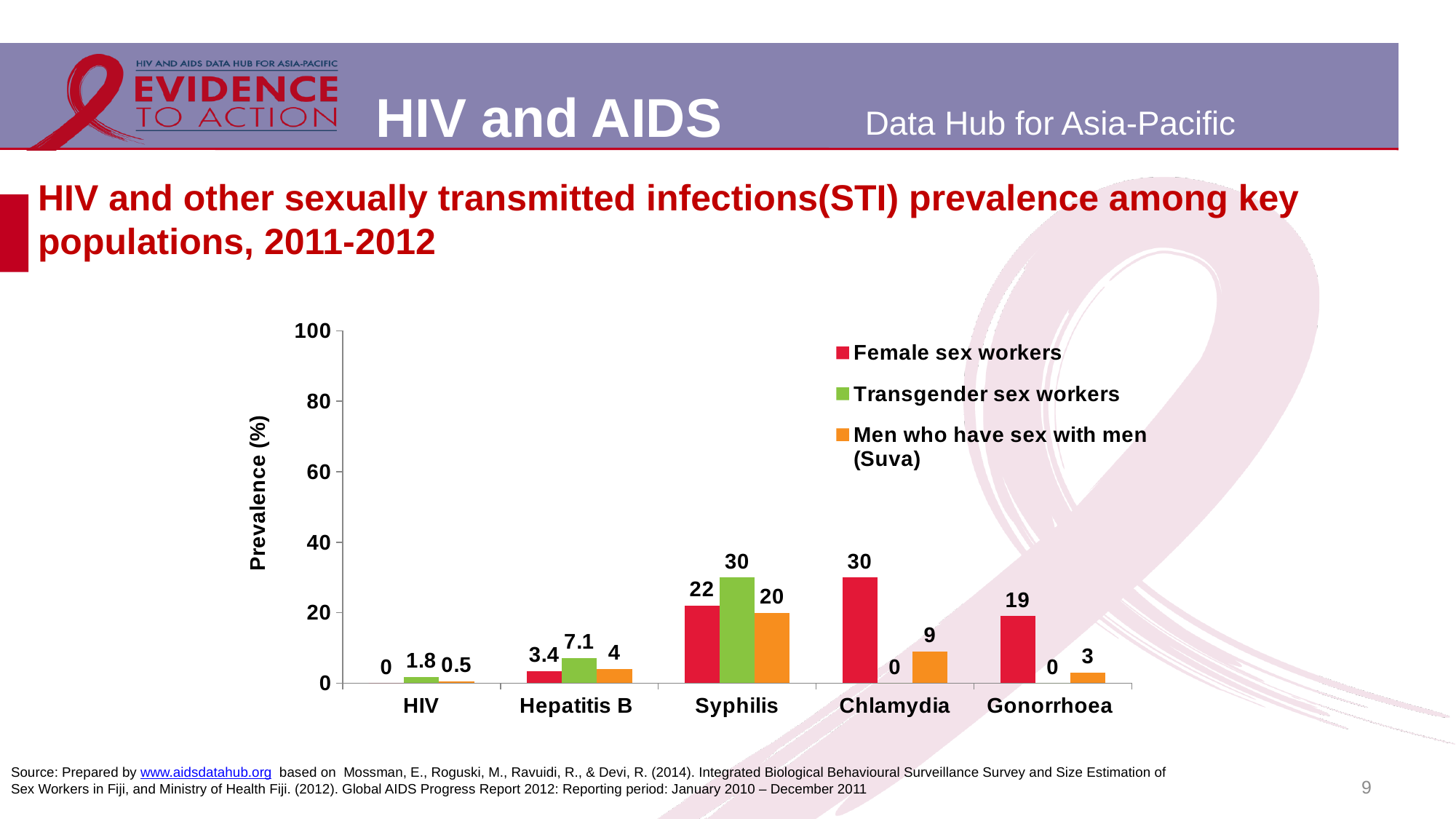
For Hepatitis B, which group has the higher prevalence: transgender sex workers or men who have sex with men (Suva)? Transgender sex workers Among female sex workers, which infection has the highest prevalence? Chlamydia What kind of chart is shown on the slide? Bar chart What is the prevalence for men who have sex with men (Suva) for Gonorrhoea? 3 How many infections are shown on the x axis? 5 What is the prevalence for female sex workers for Chlamydia? 30 Among men who have sex with men (Suva), which infection has the lowest prevalence? HIV For Syphilis, what is the difference between the prevalence for transgender sex workers and for men who have sex with men (Suva)? 10 What is the prevalence for transgender sex workers for Syphilis? 30 For Gonorrhoea, what is the difference between the prevalence for female sex workers and for men who have sex with men (Suva)? 16 What is the prevalence for transgender sex workers for Hepatitis B? 7.1 How many series does the legend list? 3